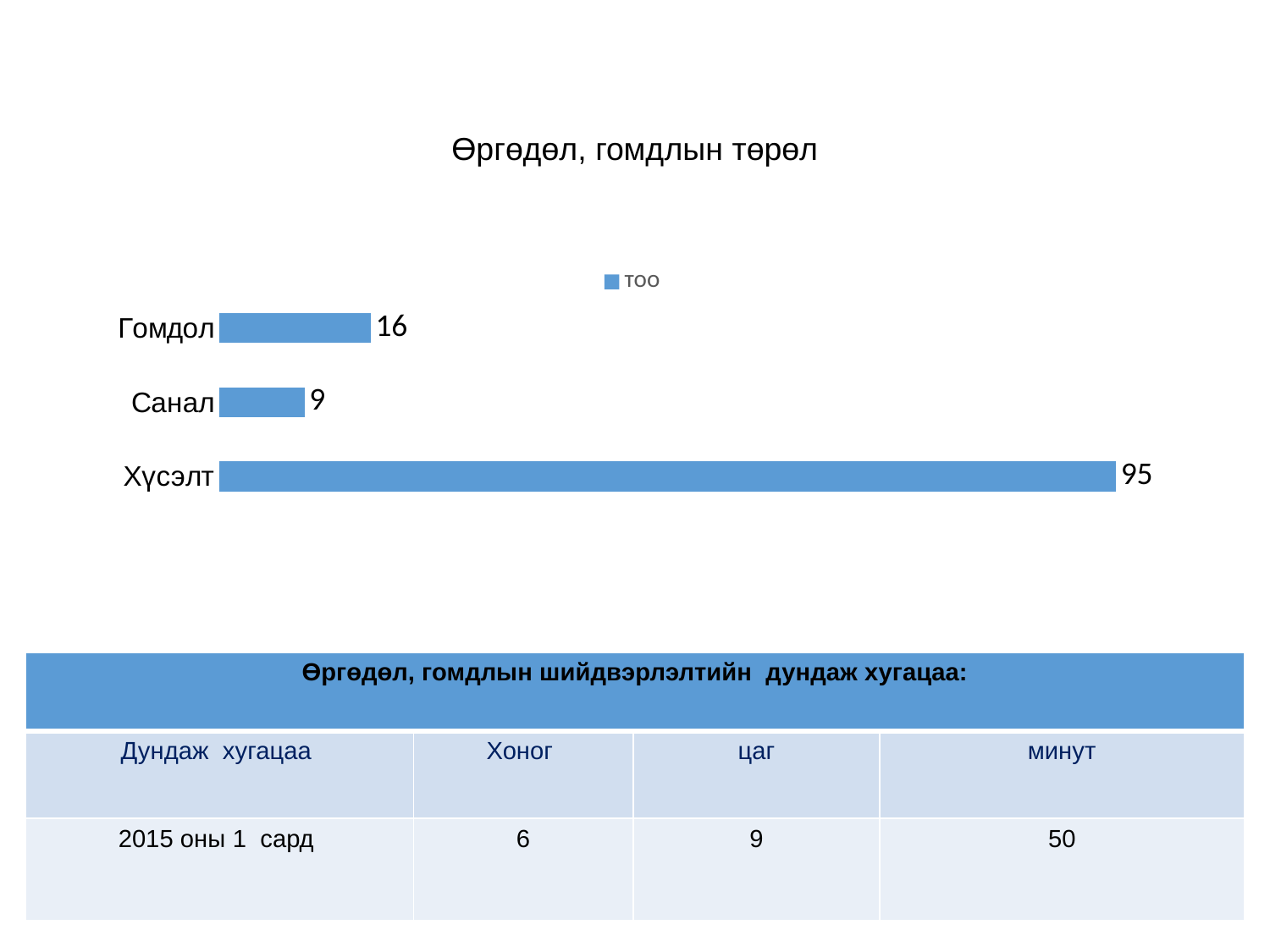
What kind of chart is shown on the slide? bar chart What is the difference between the values for Гомдол and Санал? 7 What is the title of the chart? Өргөдөл, гомдлын төрөл What is the value for Гомдол? 16 Which category has the highest value? Хүсэлт What is the value for Санал? 9 How many categories are shown in the chart? 3 Which category has the lowest value? Санал What is the difference between the values for Хүсэлт and Гомдол? 79 How many series does the legend list? 1 What is the value for Хүсэлт? 95 Which is larger, the value for Гомдол or the value for Санал? Гомдол